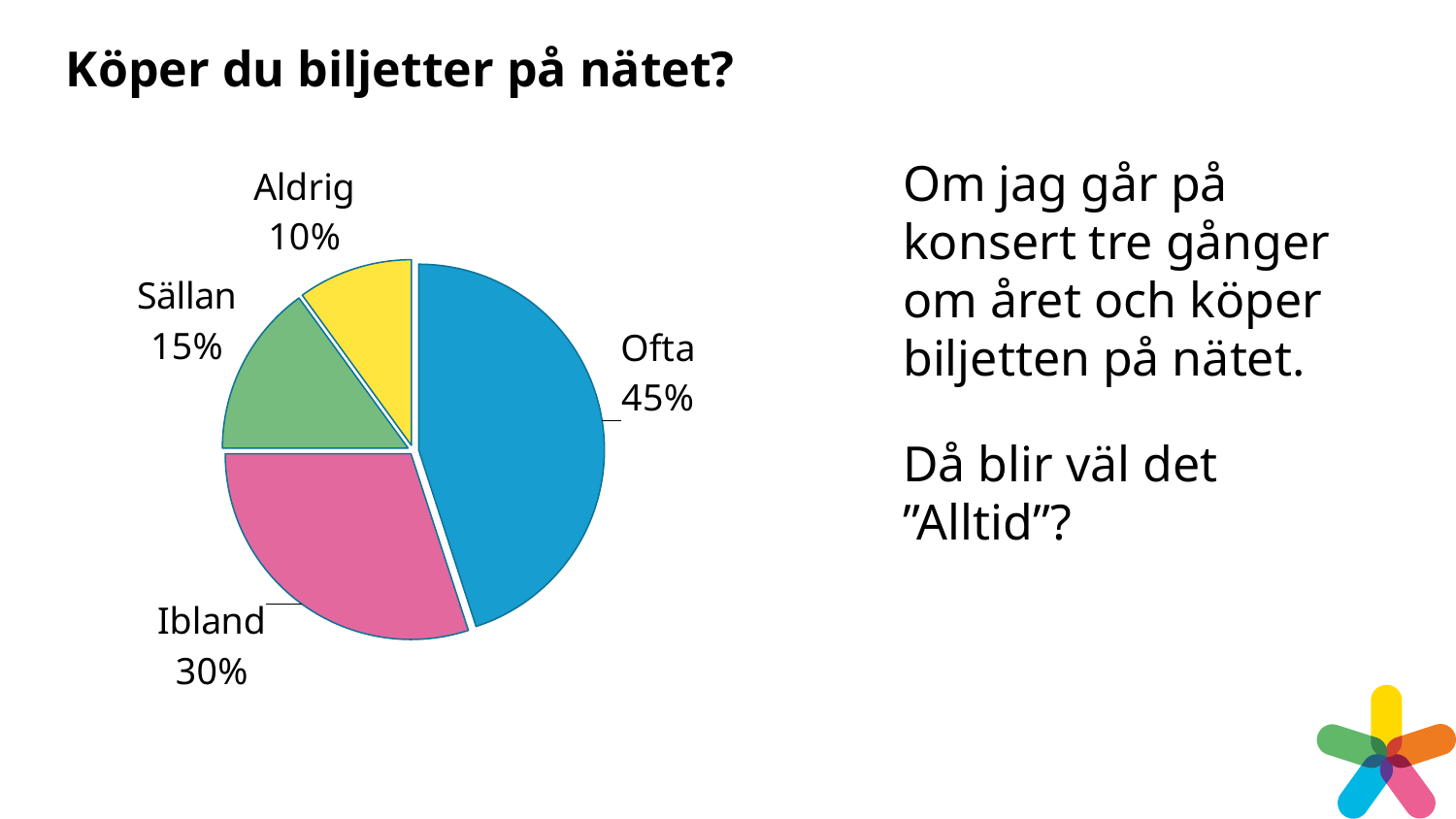
Which is larger, the share for "Ibland" or the share for "Sällan"? Ibland What is the difference between the shares for "Sällan" and "Aldrig"? 5% What share of the pie does "Ibland" have? 30% What kind of chart is shown on the slide? pie chart What is the difference between the shares for "Ofta" and "Ibland"? 15% What share of the pie does "Aldrig" have? 10% What share of the pie does "Sällan" have? 15% What is the title of the slide above the pie chart? Köper du biljetter på nätet? Which category has the smallest slice of the pie? Aldrig Which category has the largest slice of the pie? Ofta How many slices does the pie chart have? 4